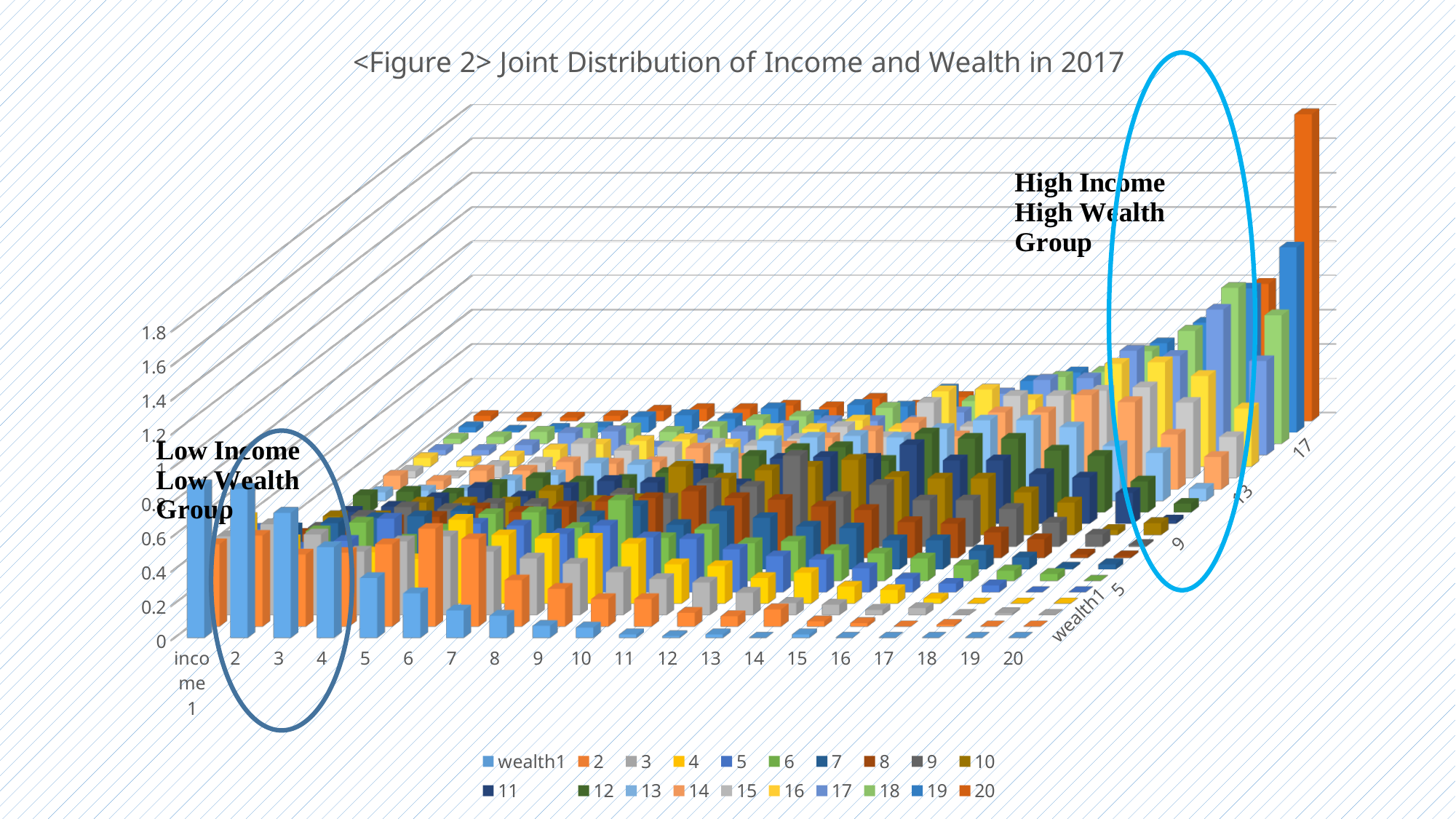
What is the highest tick value shown on the vertical axis? 1.8 How many income categories are shown along the x axis? 20 Which is larger for the wealth1 series: the value at income 2 or the value at income 10? income 2 What kind of chart is shown on the slide? 3D bar chart Does the wealth1 series rise or fall as income goes from 1 to 20? fall Which income category has the highest value for the wealth 20 series? 20 How many series does the legend list? 20 What is the title of the chart? <Figure 2> Joint Distribution of Income and Wealth in 2017 Is the value for wealth1 at income 20 greater or less than 0.2? less What is the label of the first series in the legend? wealth1 Does the wealth 20 series rise or fall as income goes from 1 to 20? rise Is the value for wealth1 at income 1 greater or less than 0.6? greater